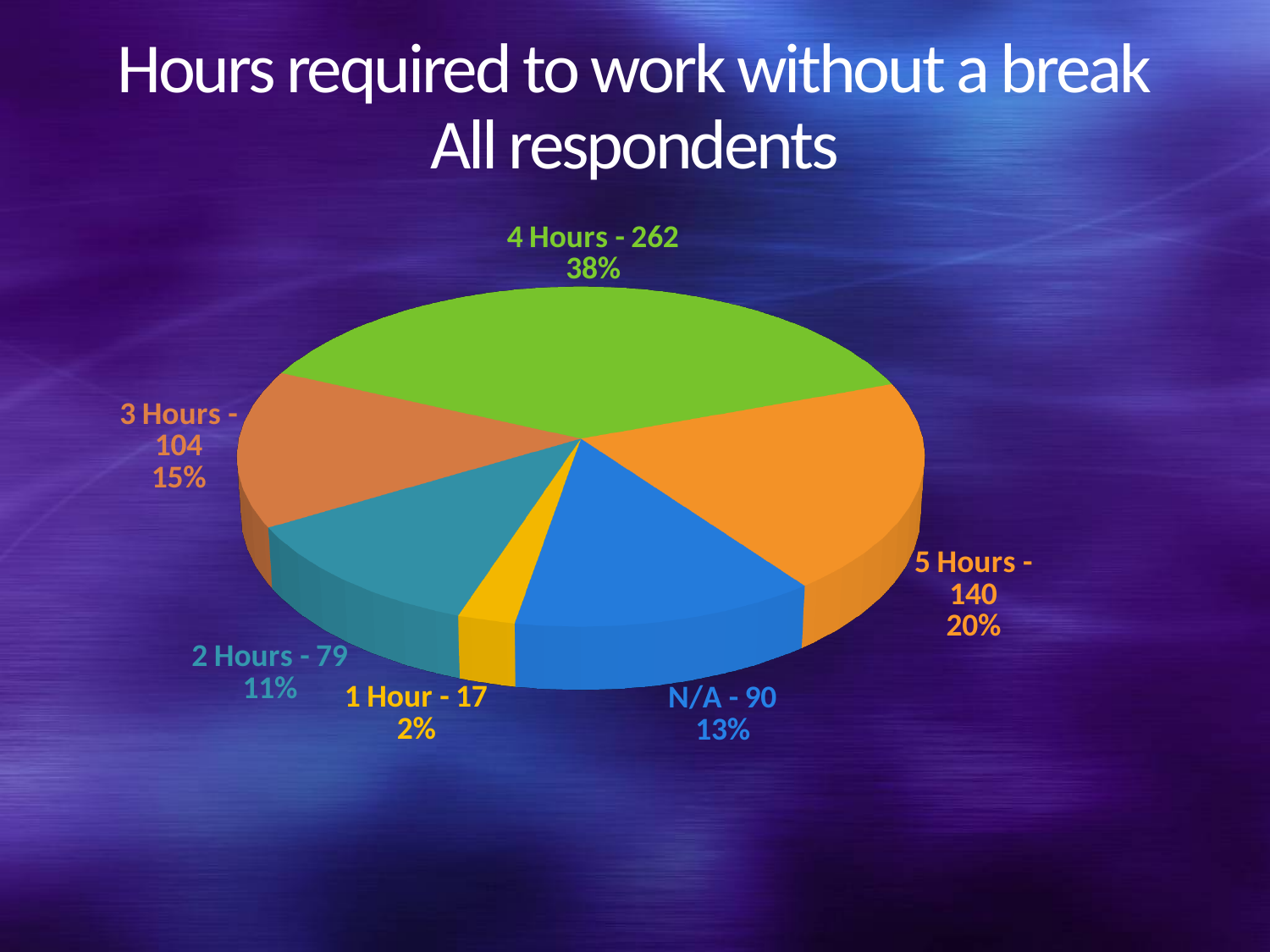
What percentage of respondents answered 2 Hours? 11% How many slices does the pie chart have? 6 Which category has the smallest share of the pie? 1 Hour How many respondents said 4 Hours? 262 Which has more respondents, 2 Hours or N/A? N/A What is the difference in respondents between 5 Hours and 3 Hours? 36 Which category has the largest share of the pie? 4 Hours How many respondents answered 1 Hour? 17 What kind of chart is shown on the slide? pie chart What percentage of respondents answered 5 Hours? 20% What is the title of the chart? Hours required to work without a break All respondents How many respondents answered N/A? 90